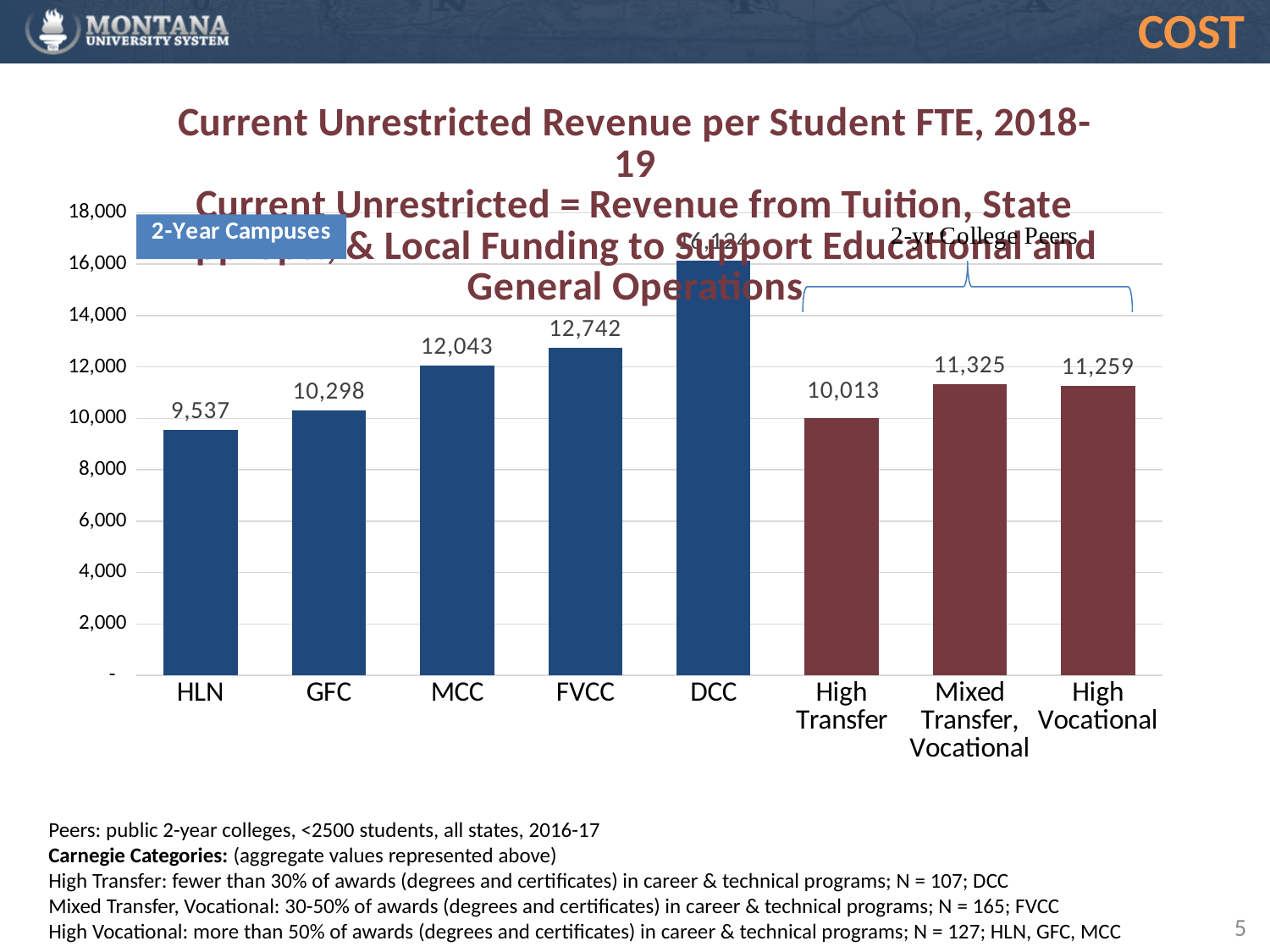
Which category has the lowest value? HLN What is the value for High Transfer? 10,013 How many categories are shown on the x axis? 8 Which category has the highest value? DCC Is the value for DCC greater or less than 14,000? greater What is the value for Mixed Transfer, Vocational? 11,325 What kind of chart is shown on the slide? Bar chart What is the value for FVCC? 12,742 What is the difference between the values for GFC and HLN? 761 What is the value for HLN? 9,537 What is the difference between the values for FVCC and MCC? 699 Which is larger, the value for MCC or the value for High Transfer? MCC